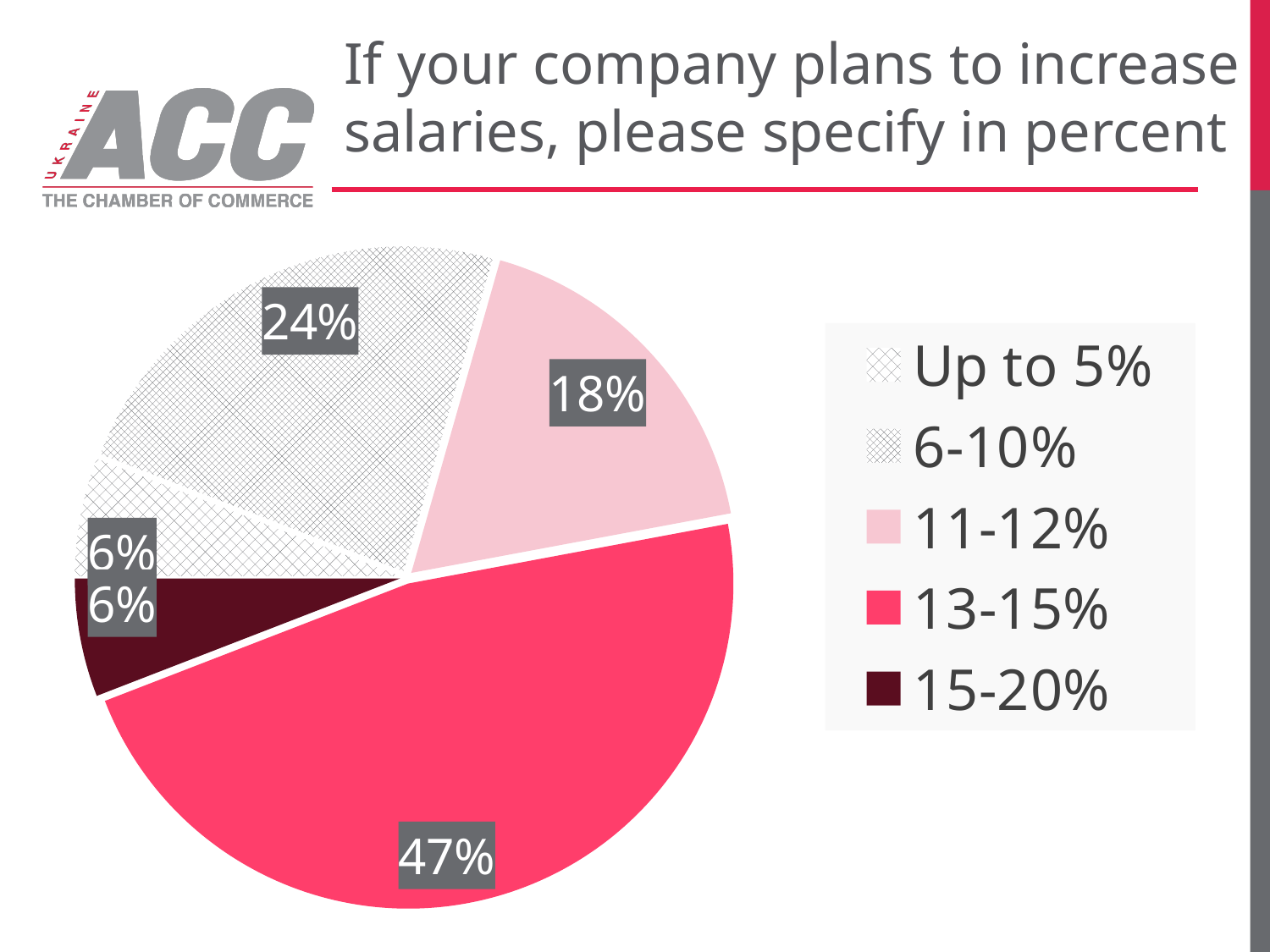
What value is shown for the 15-20% category? 6% What share of the pie corresponds to the 11-12% salary increase category? 18% Which is larger, the share for 6-10% or the share for 11-12%? 6-10% What is the title of the chart on the slide? If your company plans to increase salaries, please specify in percent What percentage of respondents plan to increase salaries by 13-15%? 47% What is the difference in percentage points between the 13-15% slice and the 11-12% slice? 29 How many categories are shown in the pie chart? 5 What kind of chart is shown on the slide? Pie chart What value is shown for the 6-10% category? 24% Which salary increase category has the largest share of the pie? 13-15% What is the combined share of the two 6% slices (Up to 5% and 15-20%)? 12% How many entries does the legend list? 5